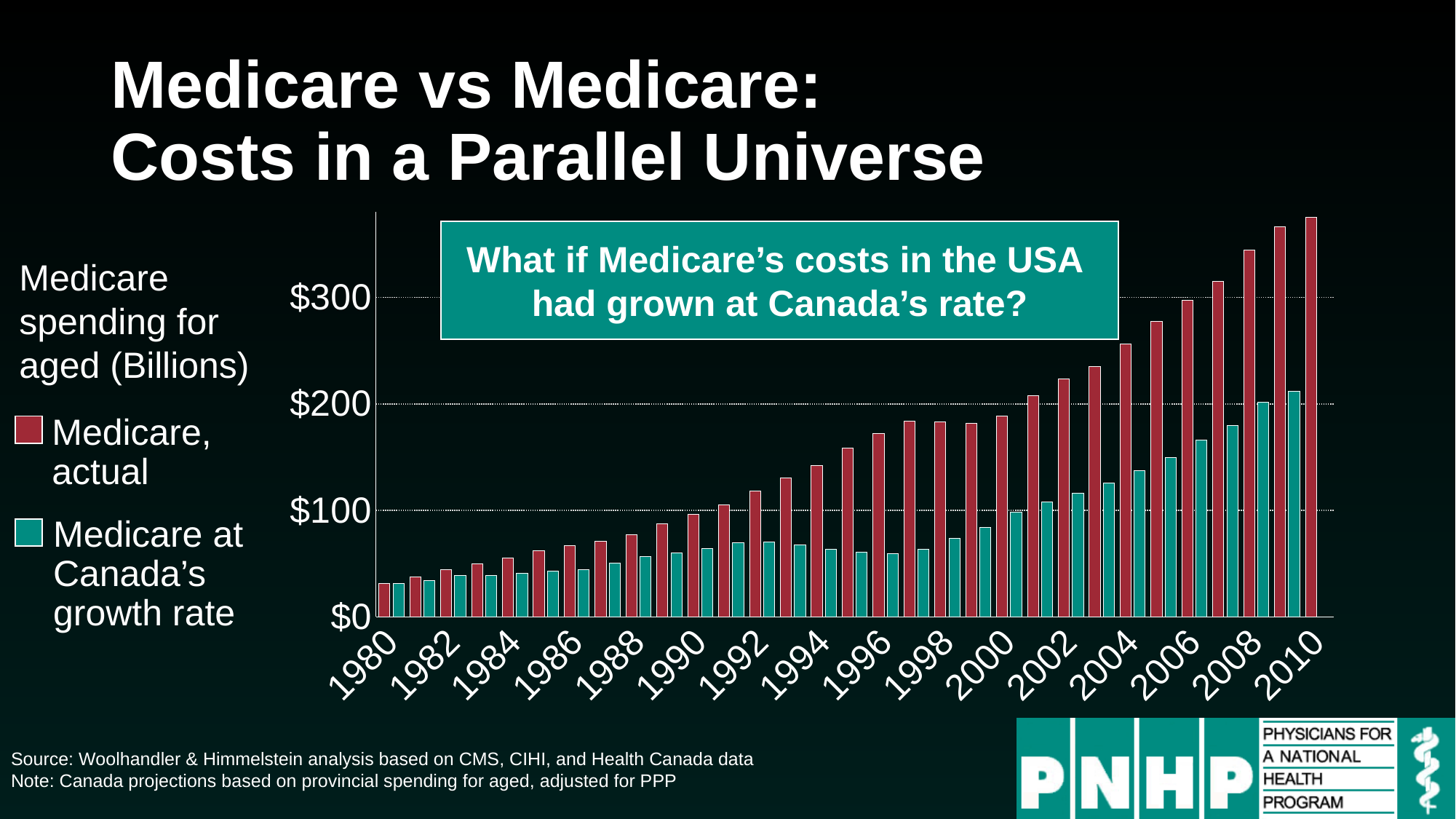
In which year is the Medicare, actual bar the highest? 2010 What question is posed in the text box overlaid on the chart? What if Medicare's costs in the USA had grown at Canada's rate? What kind of chart is shown on the slide? bar chart Do the Medicare, actual values generally rise or fall from 1980 to 2010? rise How many years are plotted on the x axis, from 1980 to 2010? 31 In which year is the Medicare at Canada's growth rate bar the lowest? 1980 Is the Medicare, actual value for 2000 greater or less than $200? less What are the two series named in the legend? Medicare, actual; Medicare at Canada's growth rate How many series does the legend list? 2 Is the Medicare, actual value for 2010 greater or less than $300? greater